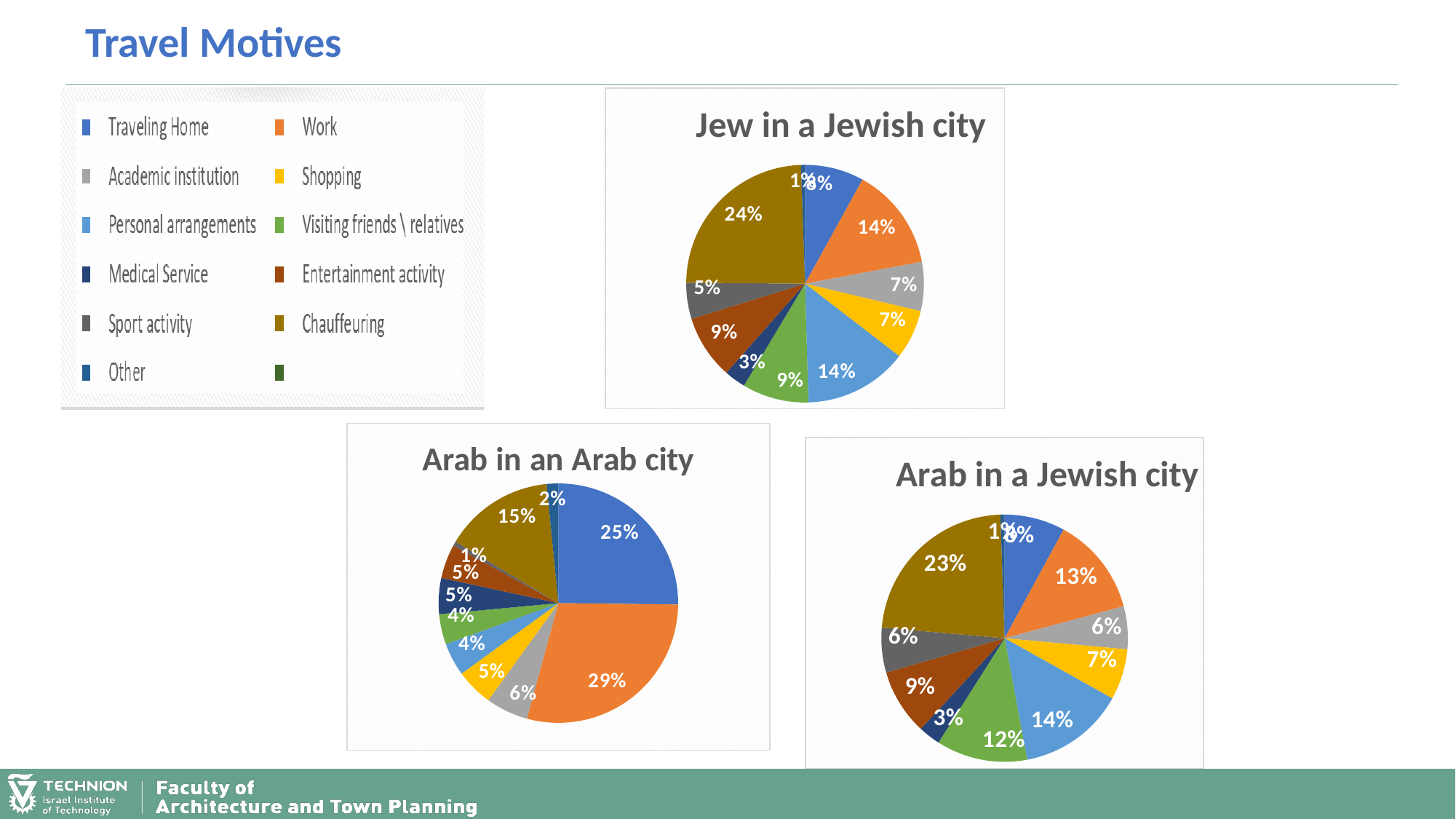
In the "Jew in a Jewish city" chart, what share is Work? 14% In the "Jew in a Jewish city" chart, which category has the largest slice? Chauffeuring In the "Jew in a Jewish city" chart, what share is Chauffeuring? 24% What kind of chart is "Arab in an Arab city"? Pie chart How many pie charts are shown on the slide? 3 In the "Arab in a Jewish city" chart, what share is Visiting friends \ relatives? 12% In the "Arab in an Arab city" chart, what share is Work? 29% In the "Arab in a Jewish city" chart, which is larger, Work or Personal arrangements? Personal arrangements In the "Arab in a Jewish city" chart, what share is Chauffeuring? 23% In the "Arab in an Arab city" chart, which category has the largest slice? Work In the "Arab in an Arab city" chart, what is the difference between the Work and Traveling Home shares? 4% In the "Arab in an Arab city" chart, what share is Traveling Home? 25%